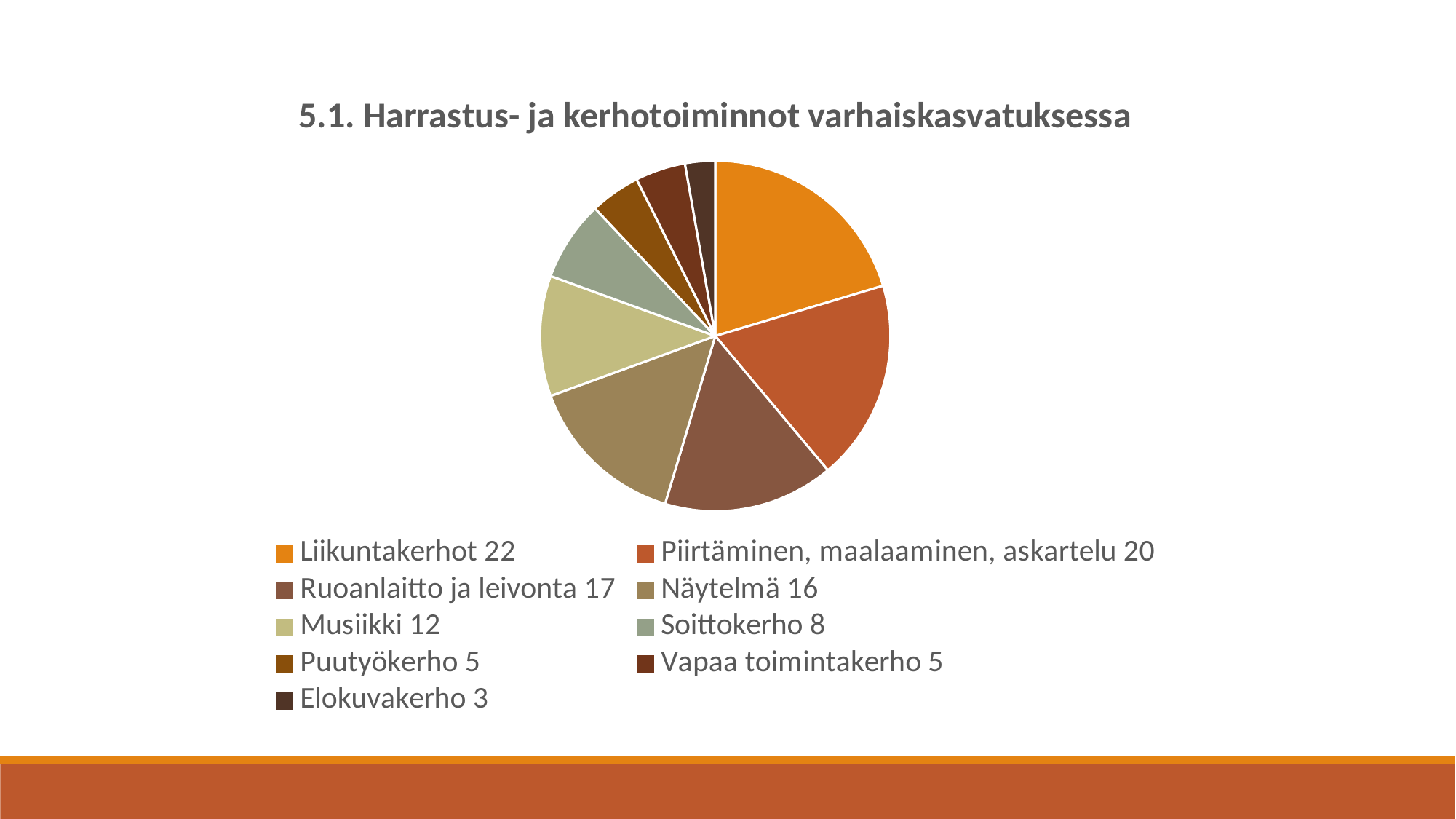
What is the value for Näytelmä? 16 Which category has the smallest slice of the pie? Elokuvakerho What is the value for Elokuvakerho? 3 What is the value for Soittokerho? 8 What kind of chart is shown on the slide? pie chart What is the difference between the values for Ruoanlaitto ja leivonta and Musiikki? 5 Which is larger, the value for Näytelmä or the value for Musiikki? Näytelmä How many categories does the pie chart have? 9 What is the difference between the values for Liikuntakerhot and Piirtäminen, maalaaminen, askartelu? 2 What is the title of the chart? 5.1. Harrastus- ja kerhotoiminnot varhaiskasvatuksessa Which category has the largest slice of the pie? Liikuntakerhot What is the value for Liikuntakerhot? 22